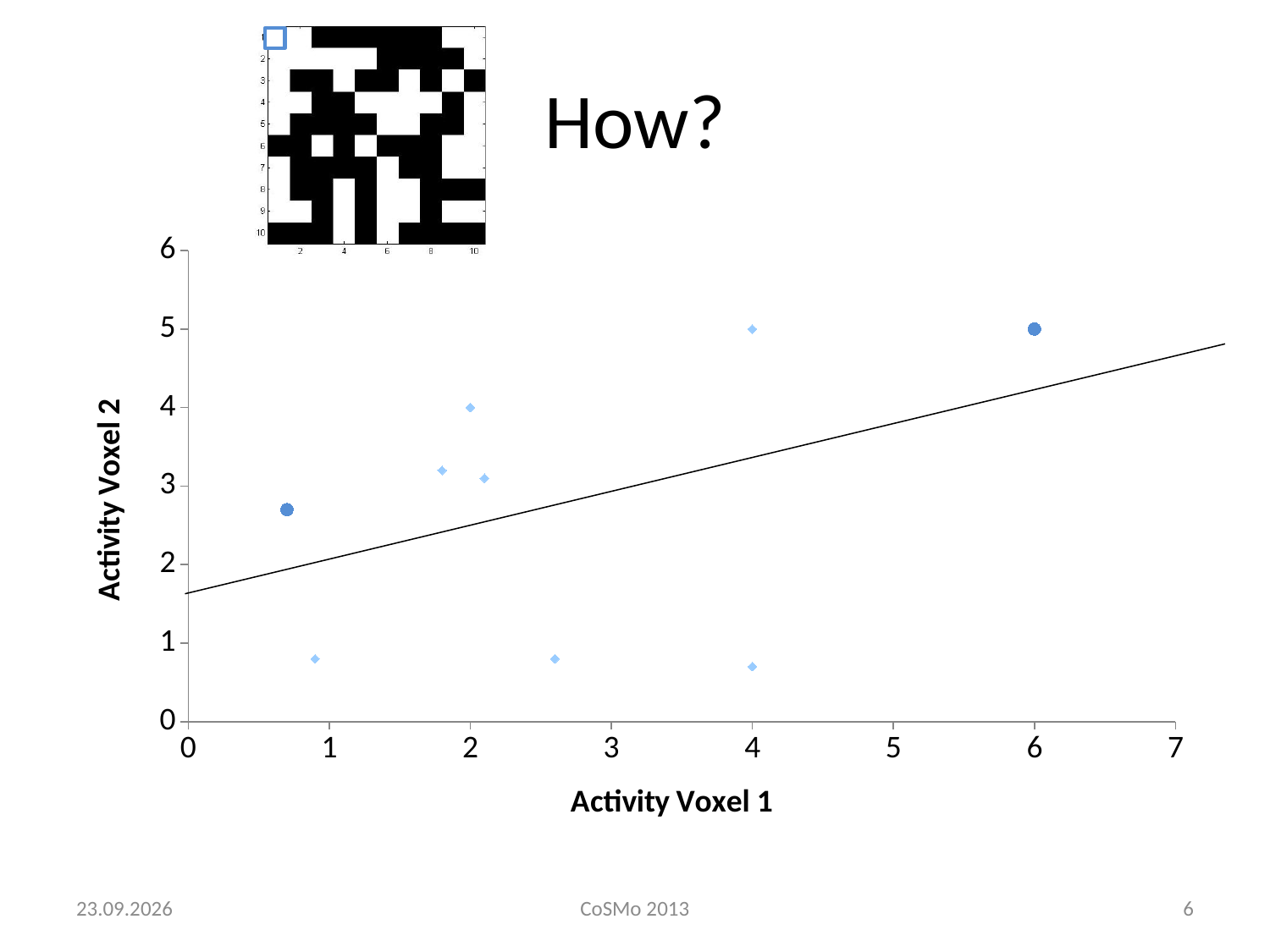
What kind of chart is shown on the slide? scatter chart Which has the higher Activity Voxel 2 value: the point at Activity Voxel 1 = 6 or the large point at Activity Voxel 1 = 0.7? the point at Activity Voxel 1 = 6 What is the title of the horizontal axis of the chart? Activity Voxel 1 What is the Activity Voxel 2 value of the point plotted at Activity Voxel 1 = 6? 5 Does the fitted straight line rise or fall as Activity Voxel 1 increases? rises Is the Activity Voxel 2 value of the large point near Activity Voxel 1 = 0.7 greater or less than 2? greater What is the highest Activity Voxel 1 value among the plotted points? 6 What is the title of the vertical axis of the chart? Activity Voxel 2 What is the highest tick value shown on the horizontal axis? 7 Is the Activity Voxel 2 value of the point at Activity Voxel 1 = 2.6 greater or less than 1? less How many data points are plotted on the chart? 9 Is the Activity Voxel 2 value of the upper point at Activity Voxel 1 = 4 greater or less than 4? greater